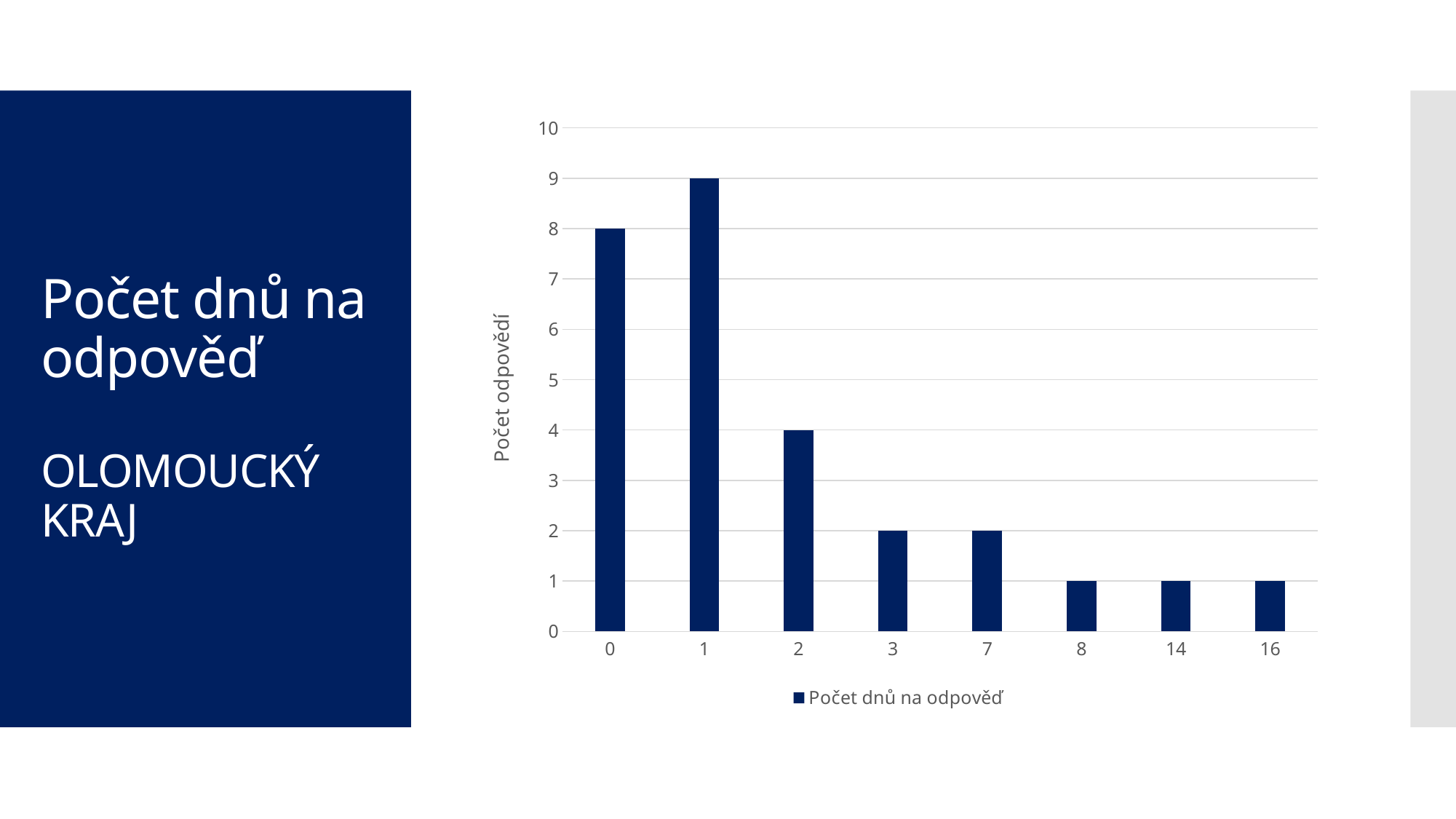
How many series does the legend list? 1 What is the difference between the values for category 1 and category 2? 5 What is the label of the vertical axis? Počet odpovědí Is the value for category 2 greater or less than 5? less Which category has the highest value? 1 What is the value for category 0? 8 What is the value for category 1? 9 What type of chart is shown on the slide? bar chart What is the value for category 2? 4 What is the legend entry for the series in the chart? Počet dnů na odpověď How many categories are shown on the x axis of the chart? 8 Which is larger, the value for category 0 or the value for category 3? 0